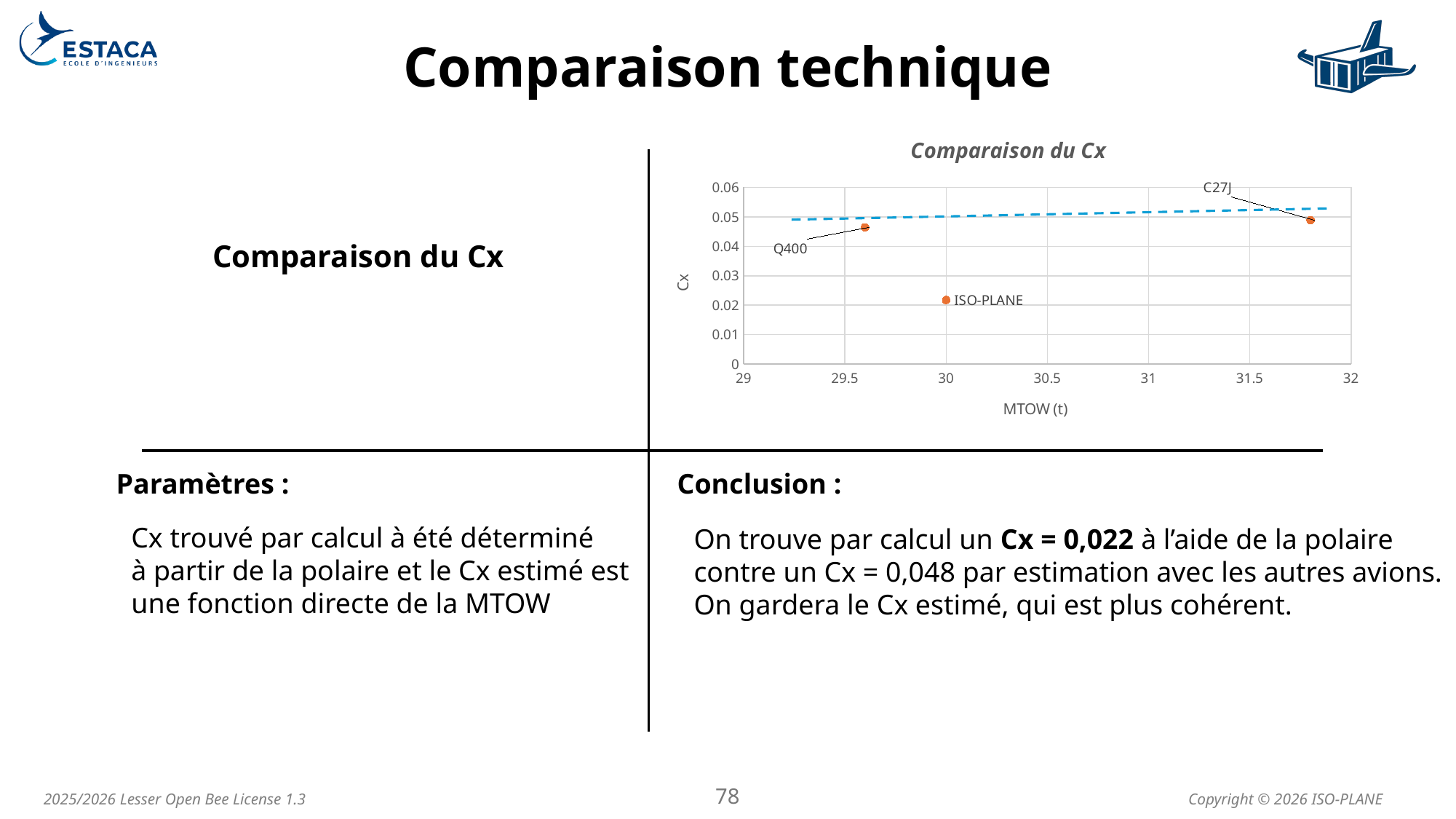
Is the MTOW for Q400 greater or less than 29.5? greater How many aircraft data points are plotted on the chart? 3 Is the MTOW for C27J greater or less than 31.5? greater Does the dashed trend line rise or fall as MTOW increases? rises Which aircraft has the highest MTOW on the chart? C27J Which has the larger Cx value, ISO-PLANE or Q400? Q400 Is the Cx value for Q400 greater or less than 0.04? greater What is the MTOW (t) of ISO-PLANE on the chart? 30 What kind of chart is shown on the slide? scatter chart What is the label of the x axis of the chart? MTOW (t) Which aircraft has the lowest Cx value on the chart? ISO-PLANE